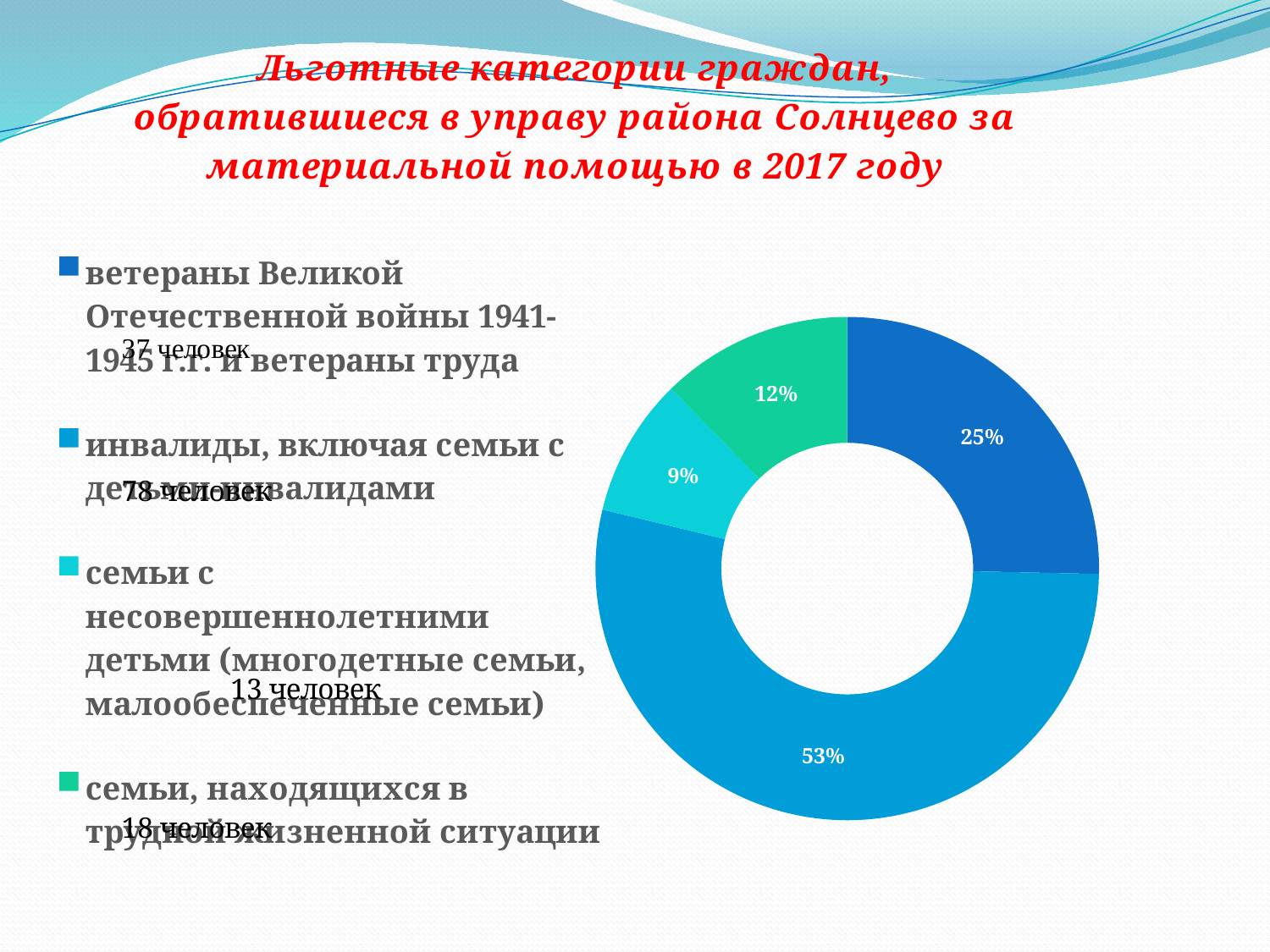
How many slices does the pie chart have? 4 What percentage of the pie chart is shown for инвалиды, включая семьи с детьми-инвалидами? 53% What percentage of the pie chart is shown for ветераны Великой Отечественной войны 1941-1945 г.г. и ветераны труда? 25% What is the difference in percentage points between the share for инвалиды and the share for ветераны? 28 Which share is larger: семьи, находящихся в трудной жизненной ситуации or семьи с несовершеннолетними детьми? семьи, находящихся в трудной жизненной ситуации How many categories does the legend list? 4 Which category has the largest share of the pie chart? инвалиды, включая семьи с детьми-инвалидами What type of chart is shown on the slide? pie chart (doughnut) What colour is the slice for инвалиды, включая семьи с детьми-инвалидами? blue What percentage of the pie chart is shown for семьи, находящихся в трудной жизненной ситуации? 12% Which category has the smallest share of the pie chart? семьи с несовершеннолетними детьми (многодетные семьи, малообеспеченные семьи) What percentage of the pie chart is shown for семьи с несовершеннолетними детьми (многодетные семьи, малообеспеченные семьи)? 9%